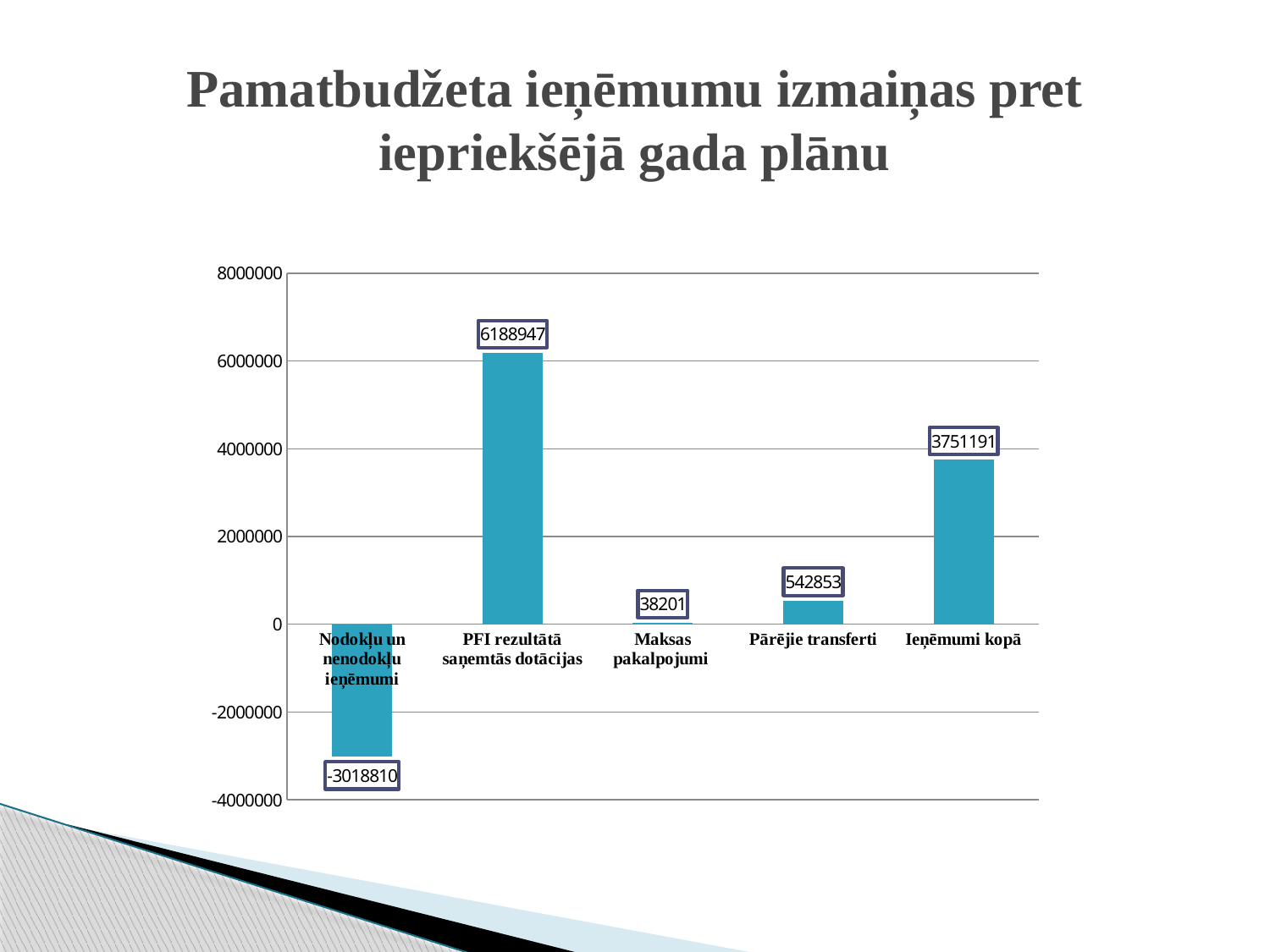
What is the difference between the values for Pārējie transferti and Maksas pakalpojumi? 504652 Which category has the highest value? PFI rezultātā saņemtās dotācijas What is the value for Nodokļu un nenodokļu ieņēmumi? -3018810 What kind of chart is shown on the slide? Bar chart What is the value for PFI rezultātā saņemtās dotācijas? 6188947 What is the difference between the values for PFI rezultātā saņemtās dotācijas and Ieņēmumi kopā? 2437756 What is the value for Maksas pakalpojumi? 38201 Which is larger, the value for Pārējie transferti or the value for Maksas pakalpojumi? Pārējie transferti What is the value for Pārējie transferti? 542853 What is the value for Ieņēmumi kopā? 3751191 Which category has the lowest value? Nodokļu un nenodokļu ieņēmumi How many categories are shown in the chart? 5